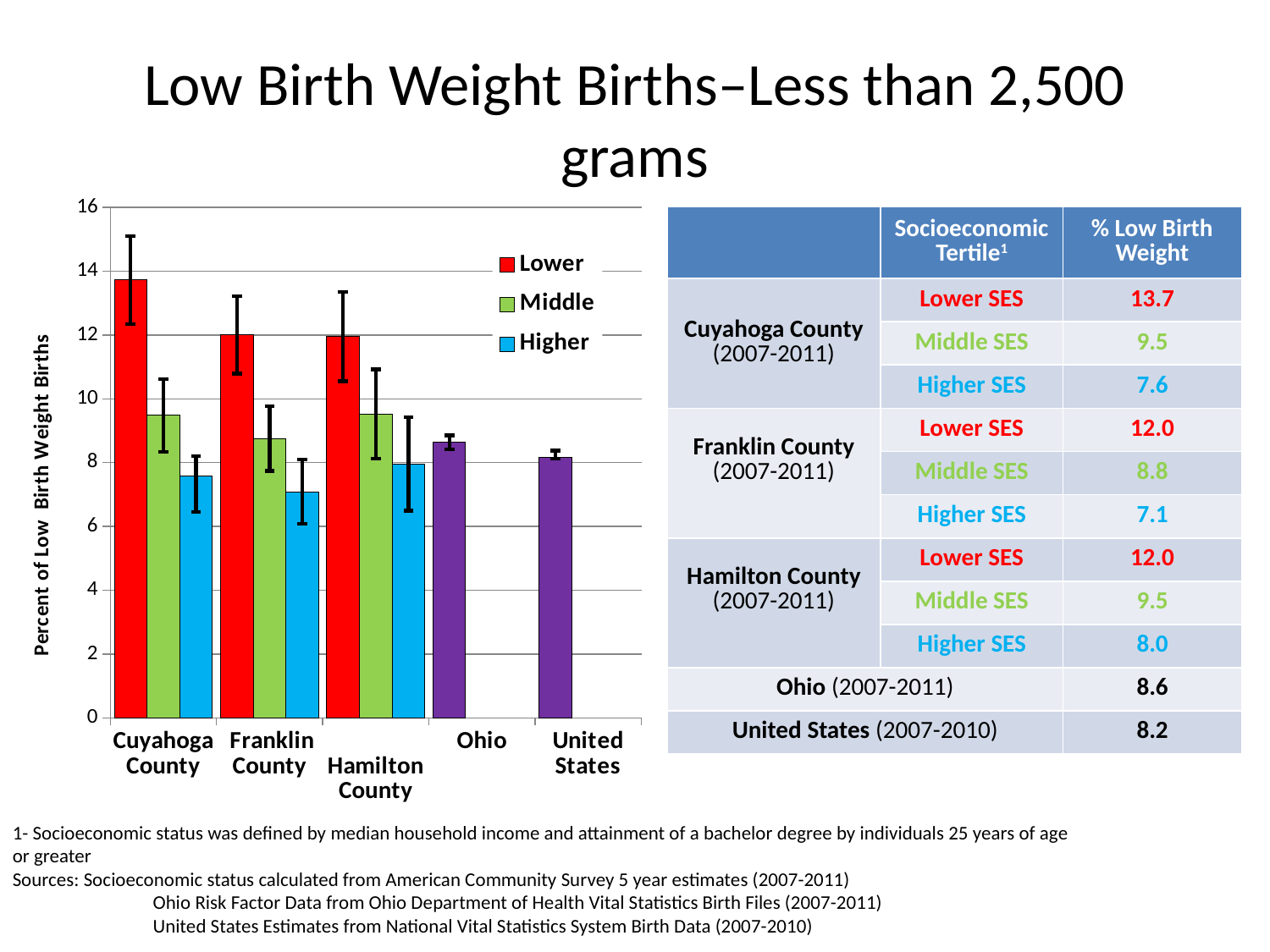
Which bar in the chart is the lowest? Higher, Franklin County Which is larger, the Lower SES value for Cuyahoga County or the Lower SES value for Franklin County? Cuyahoga County What is the percent of low birth weight births for the Higher SES tertile in Franklin County? 7.1 Is the value for the United States greater or less than 10? less What kind of chart is shown on the slide? bar chart What is the percent of low birth weight births for the Lower SES tertile in Cuyahoga County? 13.7 What is the difference between the Lower and Higher SES values for Cuyahoga County? 6.1 Which bar in the chart is the highest? Lower, Cuyahoga County What is the percent of low birth weight births for Ohio? 8.6 What is the label on the chart's vertical axis? Percent of Low Birth Weight Births How many categories are shown along the x axis of the chart? 5 How many series does the chart's legend list? 3